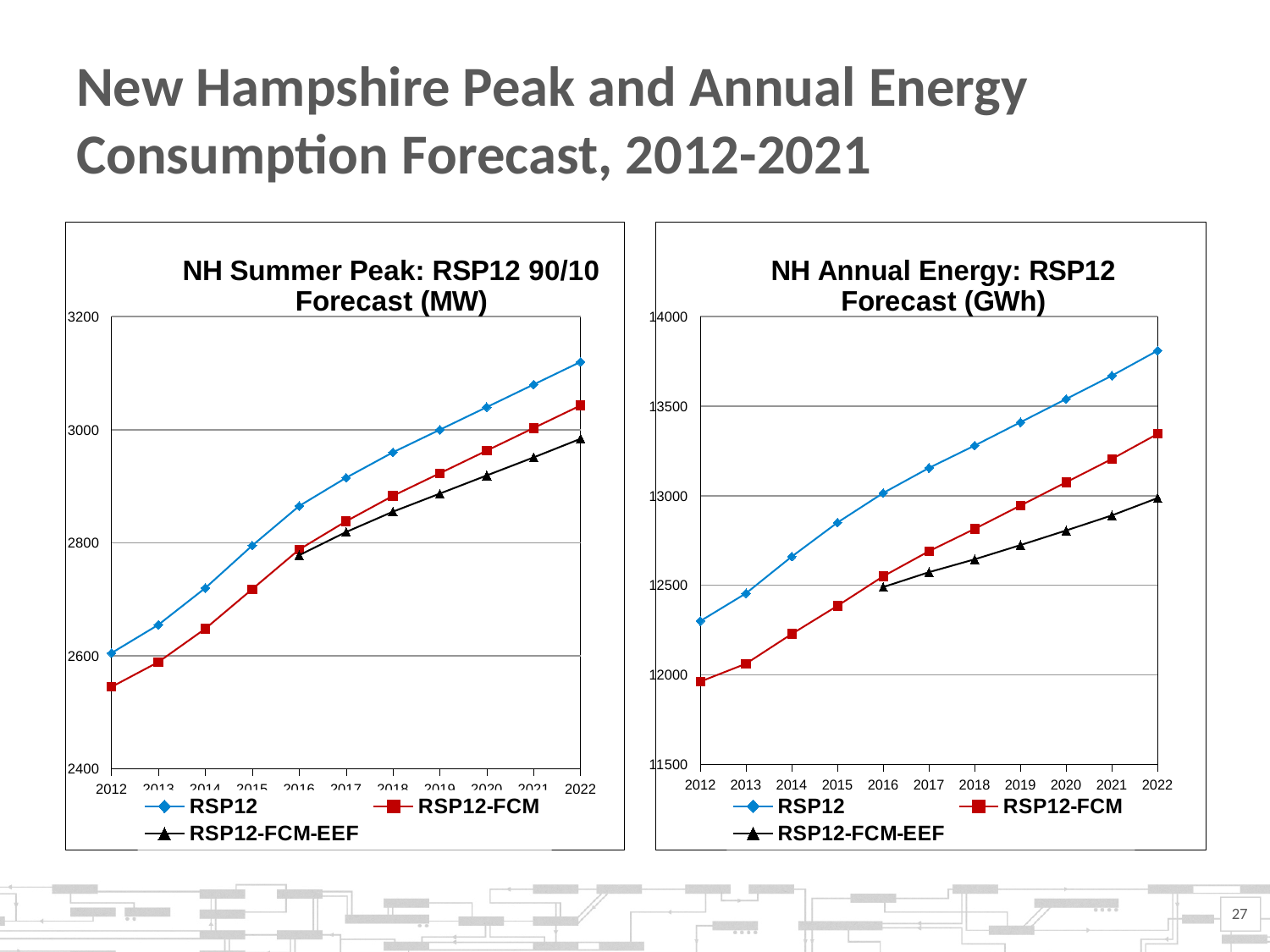
In the NH Annual Energy chart on the right, which series has the highest value in 2022? RSP12 In the NH Summer Peak chart on the left, which series has the lowest value in 2022? RSP12-FCM-EEF How many series does the legend of the NH Annual Energy chart on the right list? 3 In the NH Annual Energy chart on the right, which is larger in 2022: RSP12 or RSP12-FCM-EEF? RSP12 In the NH Annual Energy chart on the right, is the RSP12 value for 2022 greater or less than 13500? greater In the NH Summer Peak chart on the left, is the RSP12-FCM value for 2012 greater or less than 2600? less How many years are shown on the x axis of the NH Summer Peak chart on the left? 11 In the NH Annual Energy chart on the right, do the RSP12 values rise or fall from 2012 to 2022? rise What unit is given in the title of the chart on the right? GWh In the NH Summer Peak chart on the left, is the RSP12 value for 2022 greater or less than 3000? greater What kind of chart is the NH Summer Peak chart on the left? line chart